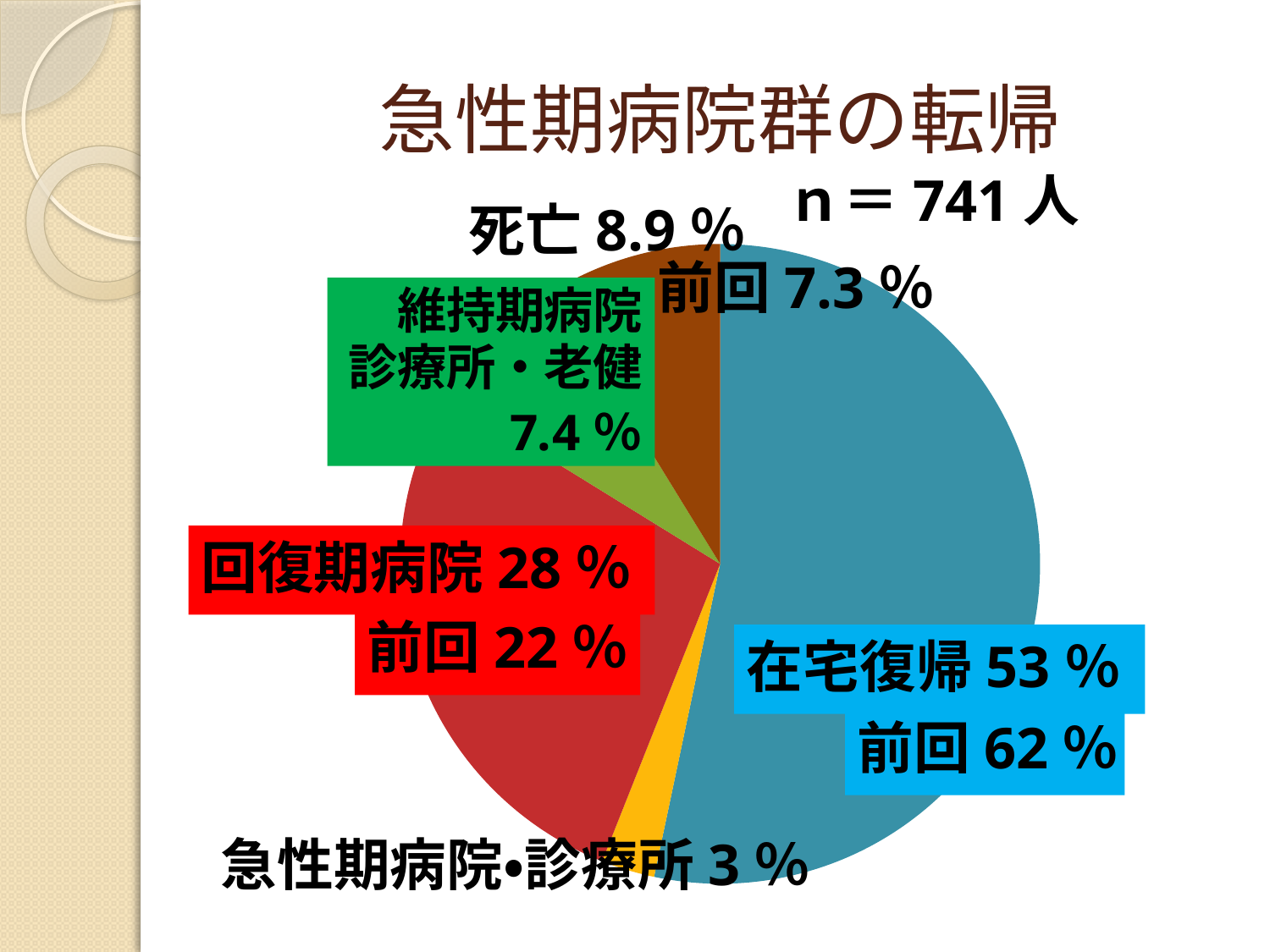
What percentage of the pie is 急性期病院・診療所? 3 % What percentage of the pie is 維持期病院・診療所・老健? 7.4 % What percentage of the pie is 在宅復帰? 53 % How many slices does the pie chart have? 5 Which category has the smallest share of the pie? 急性期病院・診療所 What percentage of the pie is 死亡? 8.9 % What percentage of the pie is 回復期病院? 28 % What is the sample size (n) shown on the slide? 741 人 By how many percentage points did 在宅復帰 decrease from the previous value (前回) to the current value? 9 Which category has the largest share of the pie? 在宅復帰 What kind of chart is shown on the slide? Pie chart What is the title of the chart? 急性期病院群の転帰